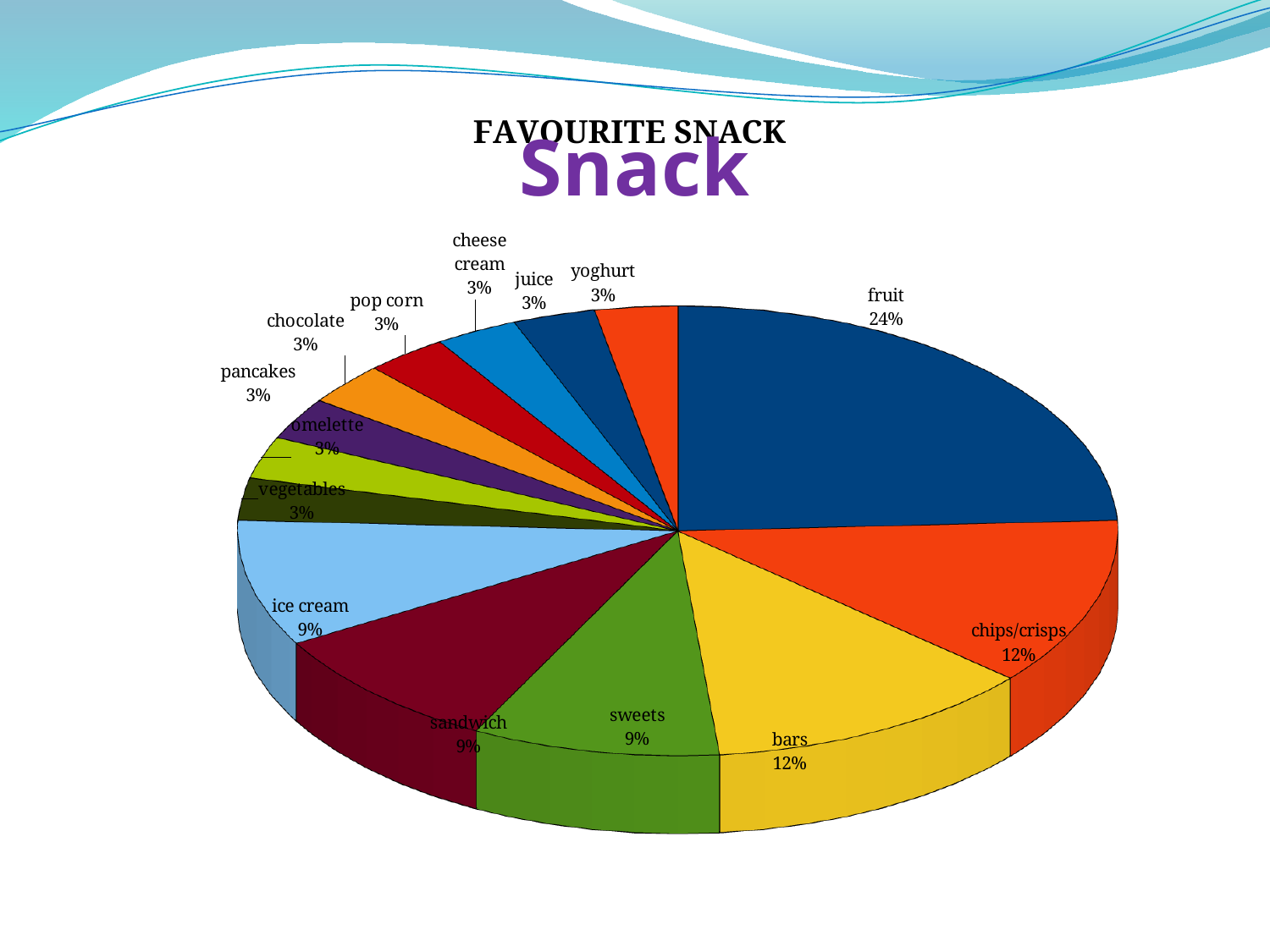
What is the difference between the share for fruit and the share for bars? 12% What is the difference between the share for sandwich and the share for juice? 6% What is the value for yoghurt? 3% What is the value for pancakes? 3% What share of the pie does fruit have? 24% What is the value for chips/crisps? 12% Which is larger, the share for sweets or the share for chips/crisps? chips/crisps What is the title of the chart? Snack What is the value for ice cream? 9% What kind of chart is shown on the slide? pie chart Which snack has the largest share of the pie? fruit How many categories are shown in the pie chart? 14